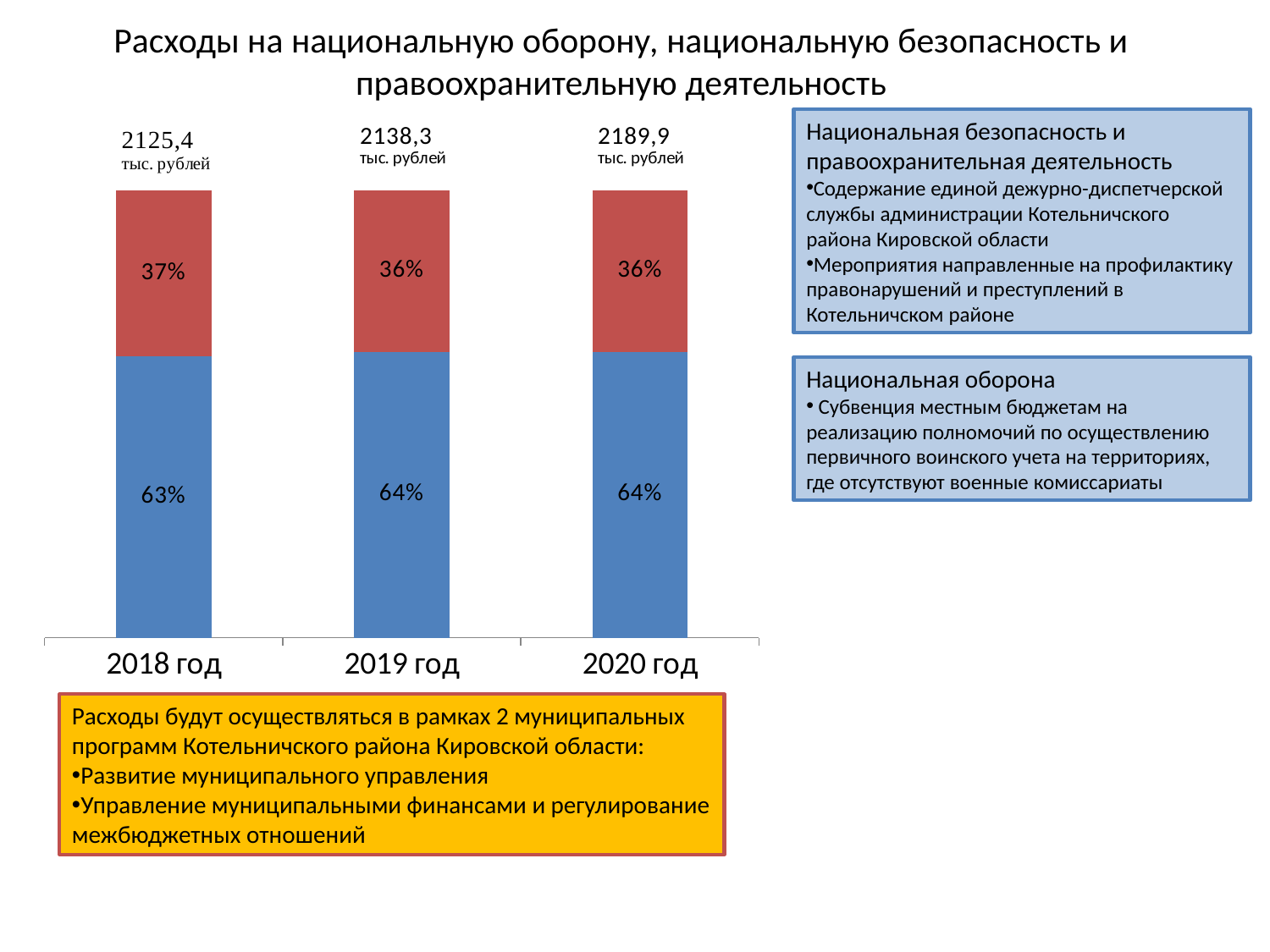
What percentage is labelled on the blue (lower) segment of the 2018 год bar? 63% Which year has the highest total value? 2020 год By how much does the total for 2020 год exceed the total for 2018 год? 64,5 тыс. рублей How many years (bars) are shown on the chart? 3 What is the total value shown above the bar for 2018 год? 2125,4 тыс. рублей Which has the larger total, 2019 год or 2020 год? 2020 год What kind of chart is shown on the slide? Stacked bar chart Do the total values rise or fall from 2018 год to 2020 год? Rise What is the difference between the totals for 2019 год and 2018 год? 12,9 тыс. рублей What is the total value shown above the bar for 2020 год? 2189,9 тыс. рублей What percentage is labelled on the red (upper) segment of the 2019 год bar? 36% Which year has the lowest total value? 2018 год